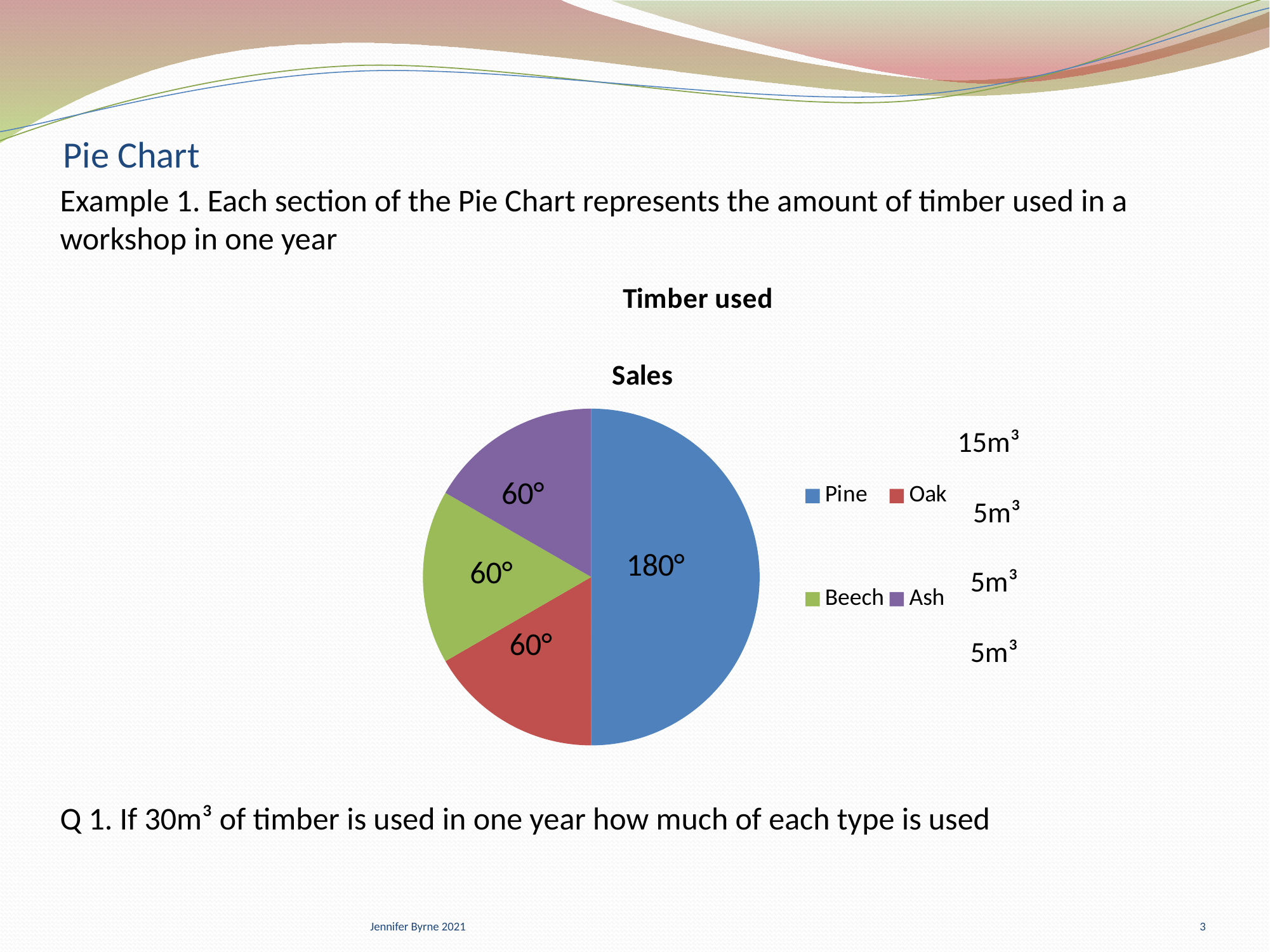
How many entries does the legend of the pie chart list? 4 What share of the whole pie does the Pine slice represent? 50% What colour is the Ash slice in the pie chart? purple Which category has the largest slice in the pie chart? Pine What is the angle label shown on the Ash slice of the pie chart? 60° How many slices does the pie chart have? 4 What is the angle label shown on the Beech slice of the pie chart? 60° What is the angle label shown on the Oak slice of the pie chart? 60° What kind of chart is shown on the slide? pie chart What is the angle label shown on the Pine slice of the pie chart? 180° What is the difference in degrees between the Pine slice and the Oak slice? 120° Which slice is larger, Pine or Beech? Pine